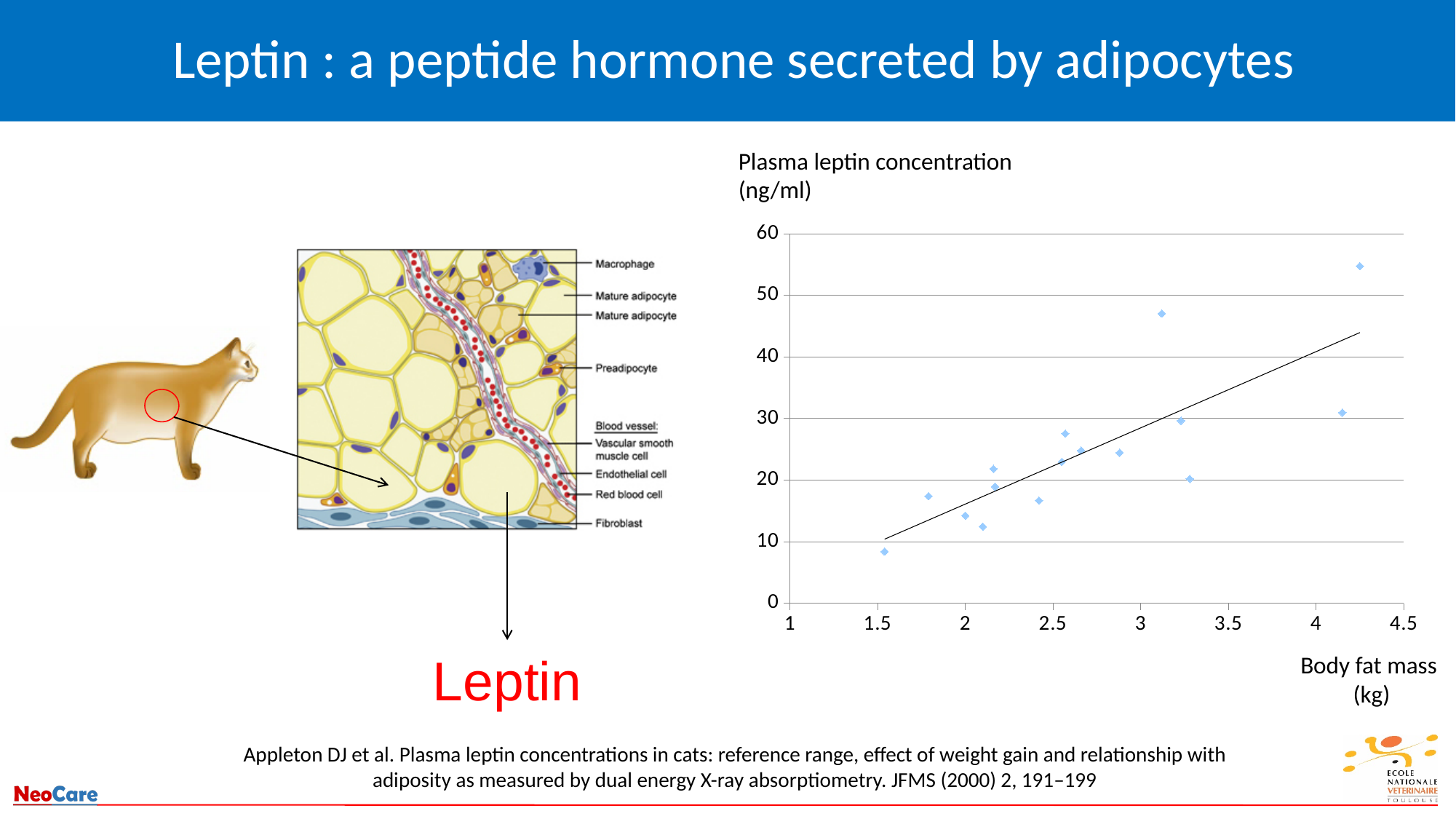
Is the plasma leptin concentration of the point at about 3.1 kg body fat mass greater or less than 40 ng/ml? greater Is the plasma leptin concentration of the point with the highest body fat mass greater or less than 50 ng/ml? greater Is the plasma leptin concentration of the point with the lowest body fat mass greater or less than 10 ng/ml? less What is the label of the x axis of the chart? Body fat mass (kg) Does plasma leptin concentration tend to rise or fall as body fat mass increases along the x axis? rise Which point has the higher plasma leptin concentration: the one at about 1.5 kg body fat mass or the one at about 4.25 kg body fat mass? the one at about 4.25 kg What is the label of the y axis of the chart? Plasma leptin concentration (ng/ml) What is the highest value shown on the y axis of the chart? 60 What kind of chart is shown on the slide? scatter chart